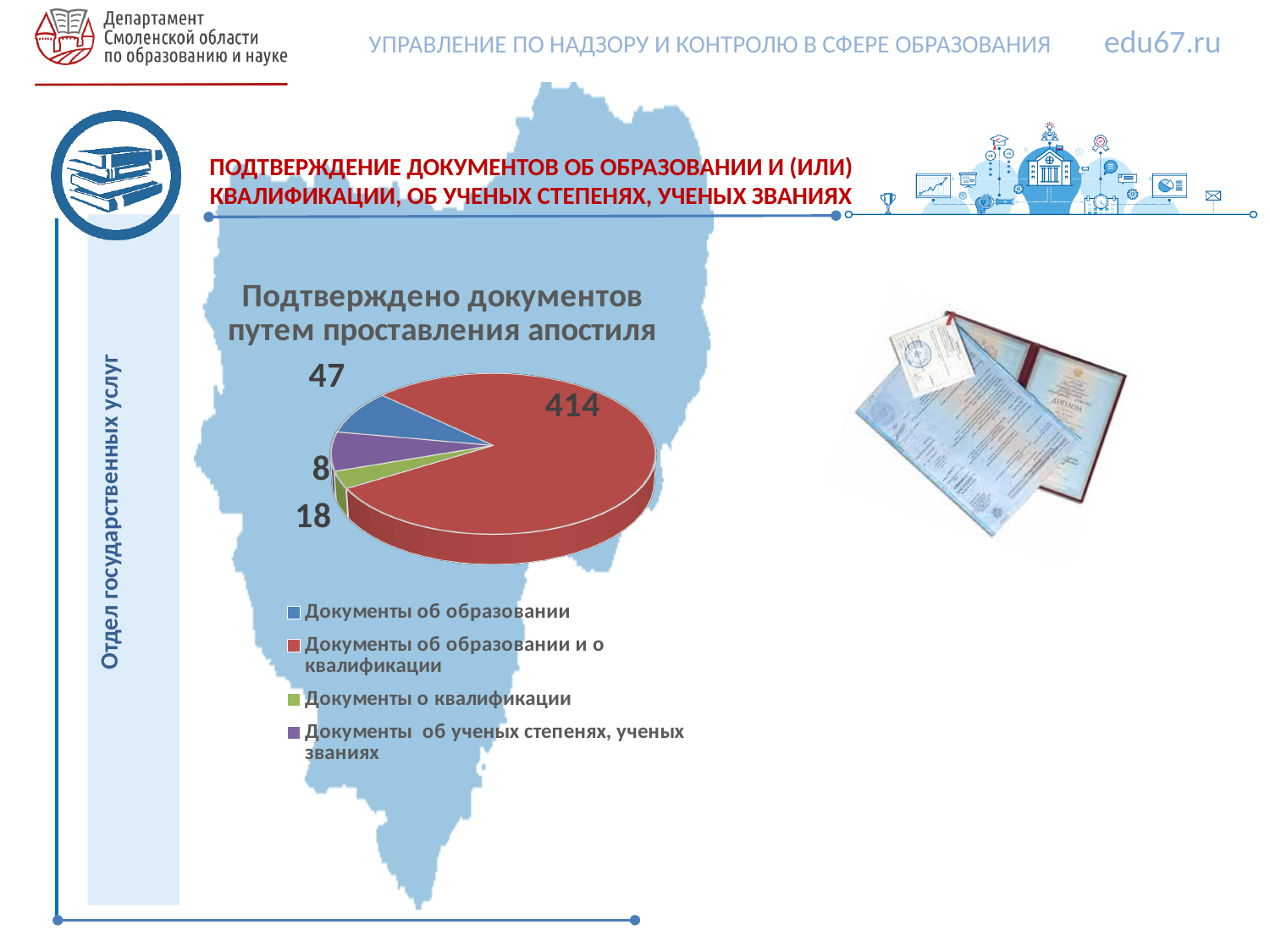
How many categories does the legend of the pie chart list? 4 What is the title of the chart? Подтверждено документов путем проставления апостиля What is the value for "Документы об ученых степенях, ученых званиях"? 8 What is the value for "Документы о квалификации"? 18 What is the value for "Документы об образовании и о квалификации"? 414 What is the value for "Документы об образовании"? 47 Which is larger: the value for "Документы об образовании" or the value for "Документы о квалификации"? Документы об образовании What is the total of all values shown in the pie chart? 487 Which category has the largest slice of the pie? Документы об образовании и о квалификации What type of chart is shown on the slide? pie chart What is the difference between the values for "Документы об образовании и о квалификации" and "Документы об образовании"? 367